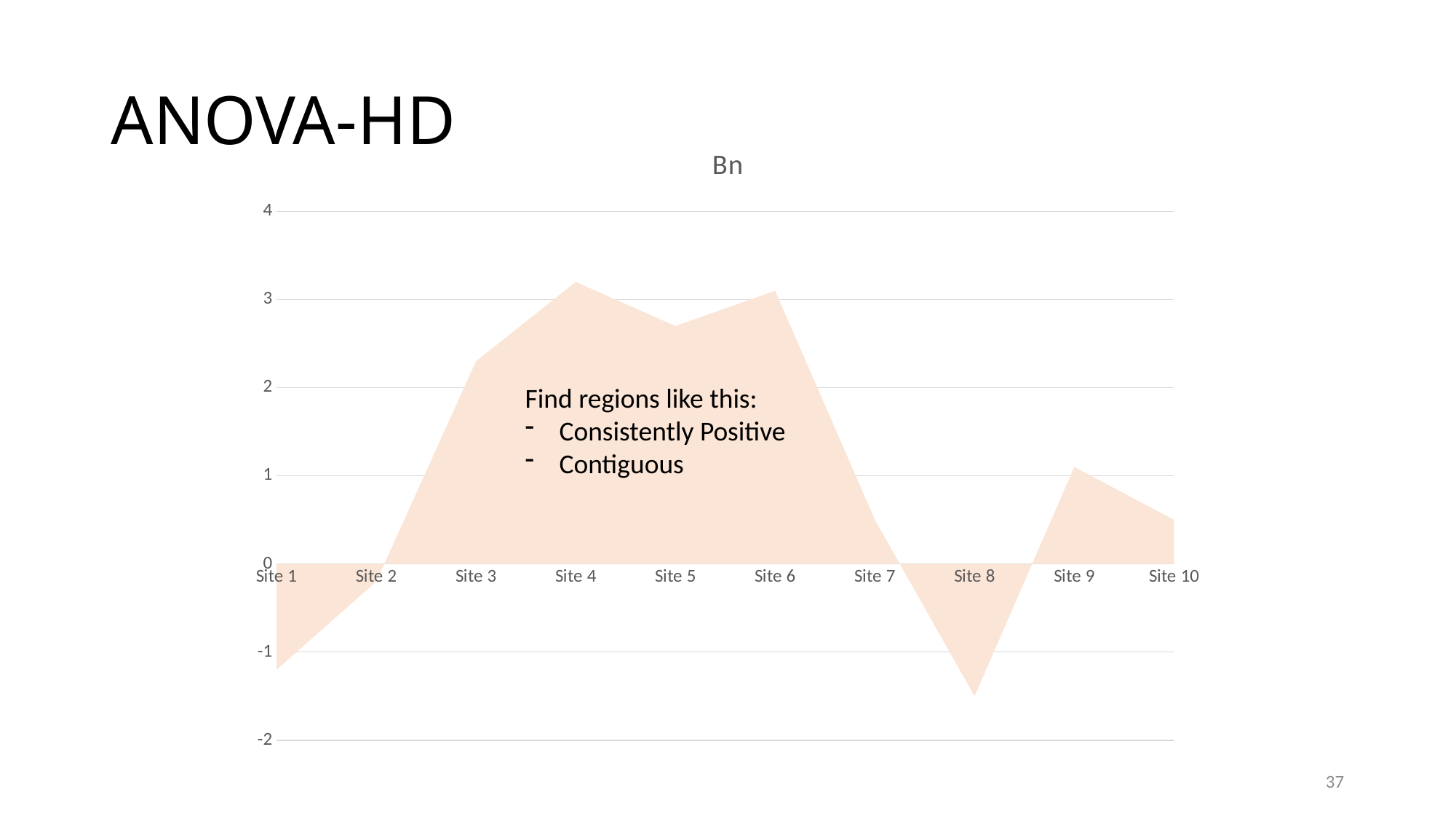
Is the value for Site 5 greater or less than 3? less Is the value for Site 1 greater or less than -1? less Is the value for Site 4 greater or less than 3? greater What is the title of the chart? Bn How many sites are plotted along the x axis? 10 Which is larger, the value for Site 3 or the value for Site 7? Site 3 Which site has the lowest value? Site 8 What kind of chart is shown on the slide? area chart Do the values rise or fall from Site 1 to Site 4? rise